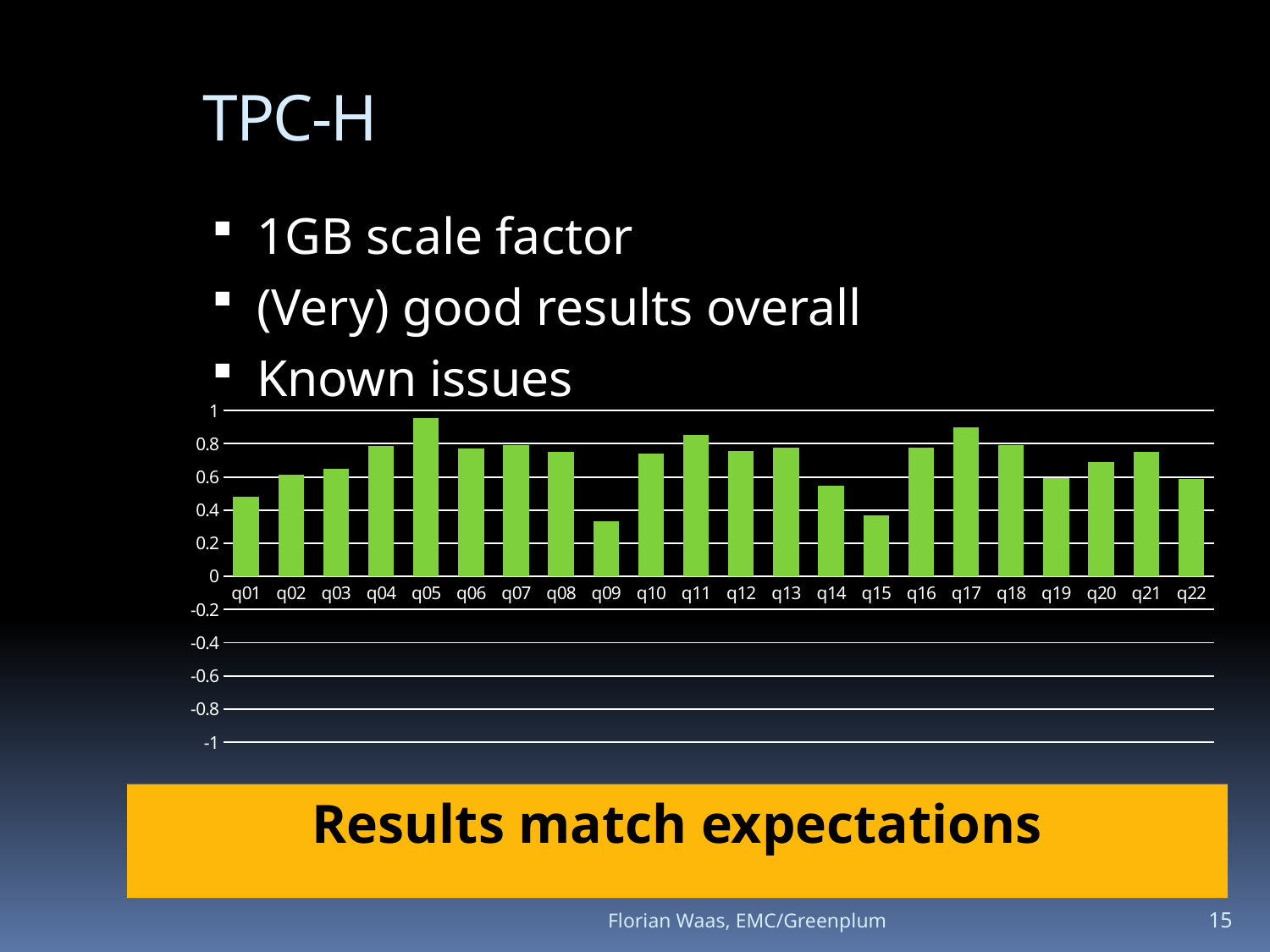
Which has the larger value, q15 or q16? q16 What colour are the bars in the chart? green Is the value for q09 greater or less than 0.4? less Which has the larger value, q11 or q14? q11 What kind of chart is shown on the slide? bar chart Is the value for q01 greater or less than 0.4? greater How many categories (queries) are plotted on the x axis of the chart? 22 Which query has the lowest bar in the chart? q09 Is the value for q14 greater or less than 0.6? less Which query has the highest bar in the chart? q05